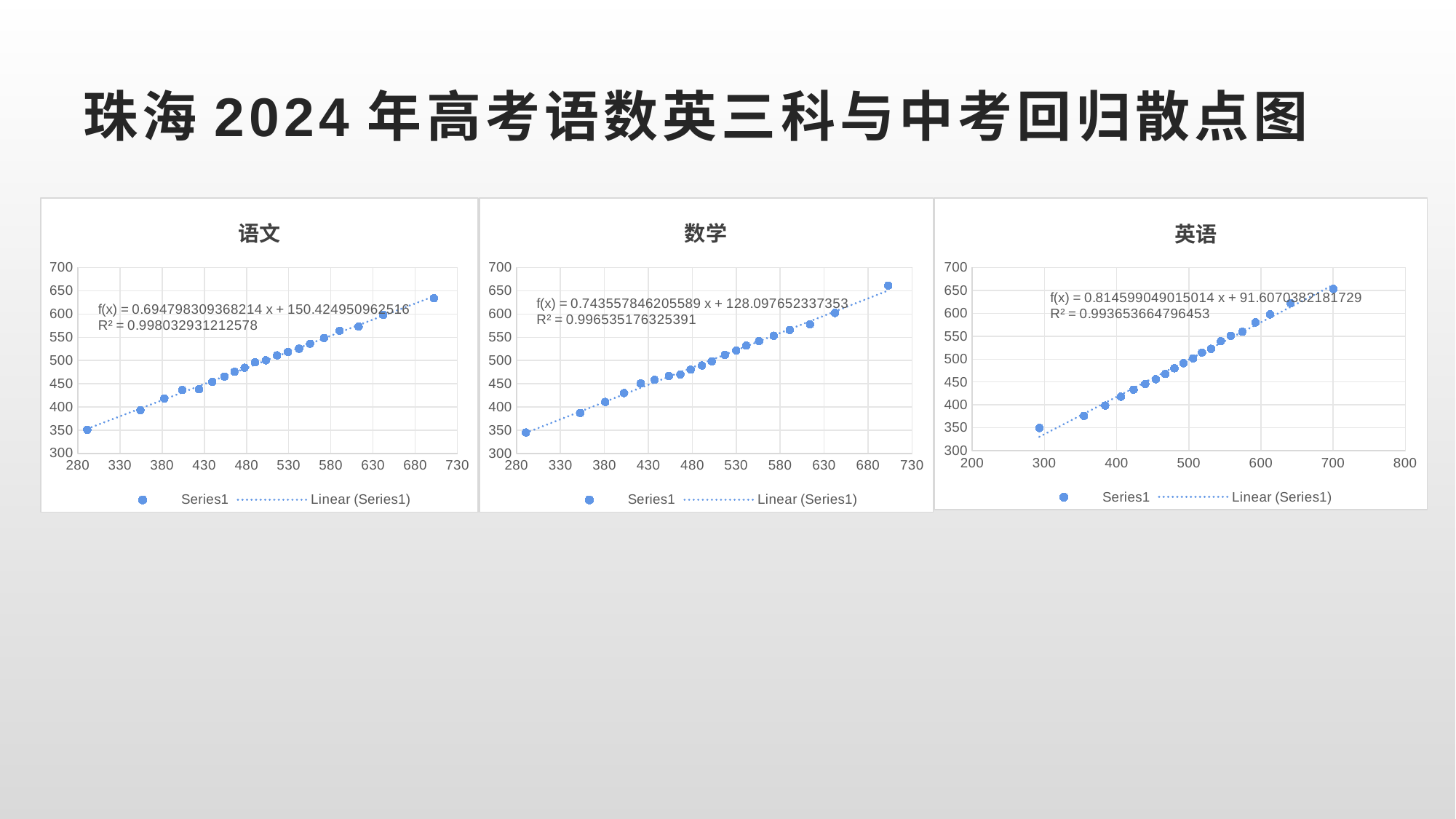
In the 英语 chart, what is the R² value shown? R² = 0.993653664796453 In the 语文 chart, what is the R² value shown? R² = 0.998032931212578 What kind of chart is the 语文 chart? scatter chart In the 英语 chart, is the y value of the rightmost point greater or less than 600? greater How many charts are shown on the slide? 3 How many entries does the legend of the 语文 chart list? 2 Which chart has the highest R² value: 语文, 数学 or 英语? 语文 In the 数学 chart, what is the R² value shown? R² = 0.996535176325391 In the 数学 chart, do the plotted values rise or fall as the x value increases? rise In the 英语 chart, what is the fitted equation shown? f(x) = 0.814599049015014 x + 91.6070382181729 In the 语文 chart, is the y value of the leftmost point greater or less than 400? less What are the two legend entries in the 英语 chart? Series1 and Linear (Series1)